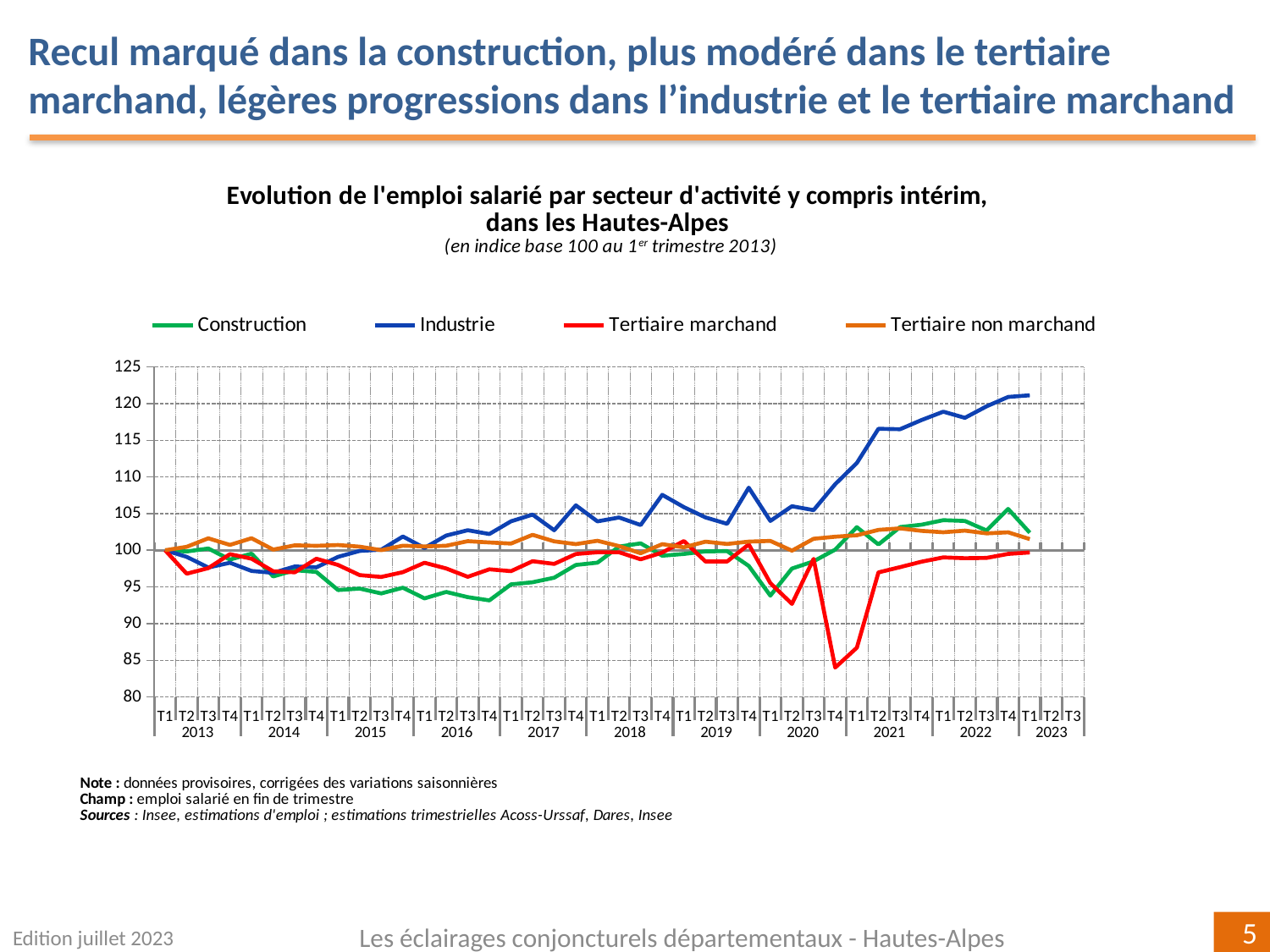
How many years are labelled on the x axis? 11 Is the value for Industrie at T4 2022 greater or less than 115? greater Which series has the lowest value at T4 2020? Tertiaire marchand Is the value for Construction at T4 2016 greater or less than 95? less How many series does the legend list? 4 What is the index value of all four series at T1 2013? 100 Which series is plotted in blue? Industrie What kind of chart is shown on the slide? line chart Is the value for Tertiaire marchand at T4 2020 greater or less than 90? less